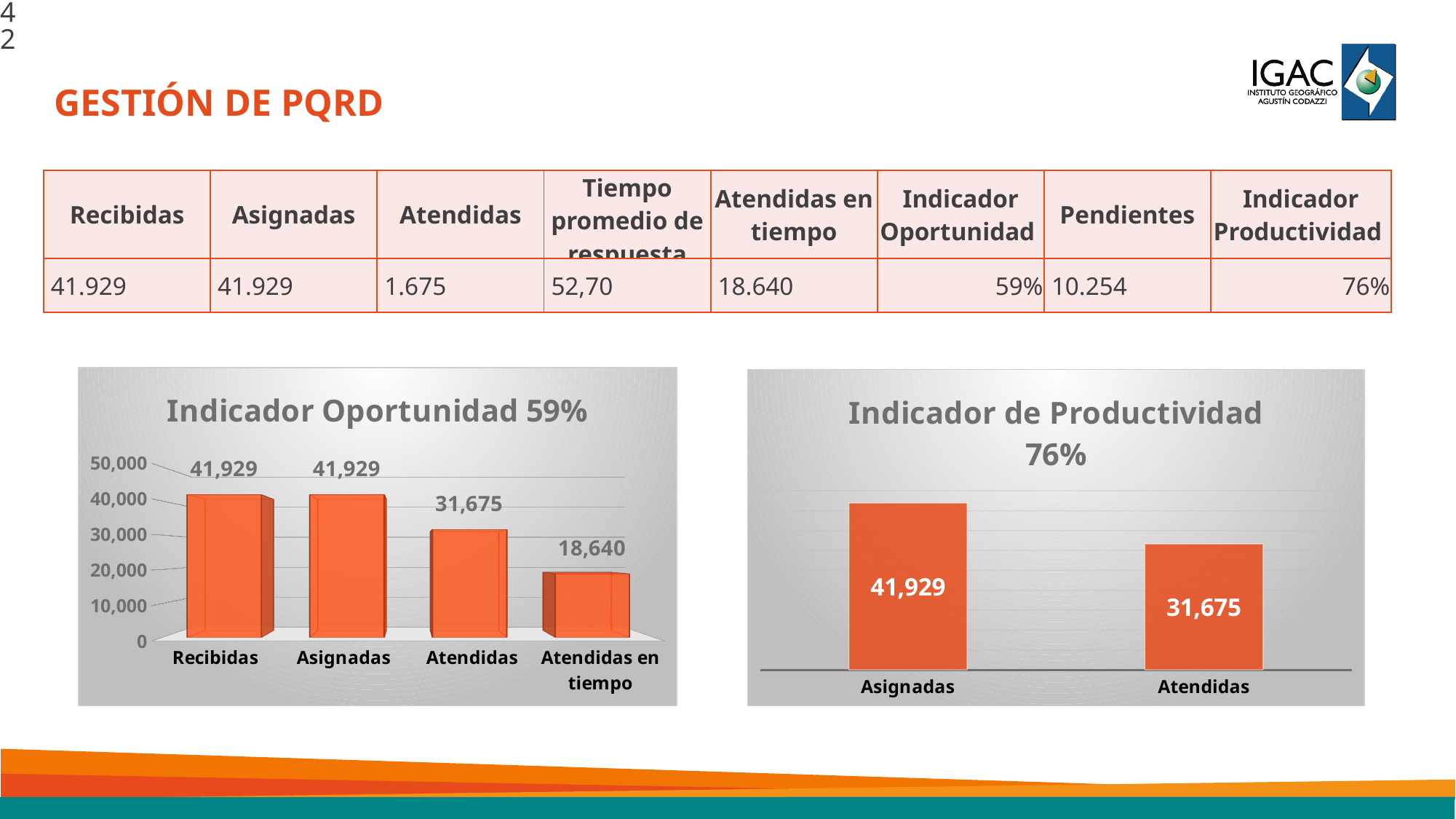
In the 'Indicador Oportunidad 59%' chart, do the values rise or fall from left to right? fall In the 'Indicador Oportunidad 59%' chart, what is the difference between Atendidas and Atendidas en tiempo? 13,035 In the 'Indicador Oportunidad 59%' chart, how many categories are shown on the x axis? 4 In the 'Indicador de Productividad 76%' chart, what is the difference between Asignadas and Atendidas? 10,254 In the 'Indicador Oportunidad 59%' chart, what is the value for Atendidas? 31,675 In the 'Indicador de Productividad 76%' chart, what is the value for Atendidas? 31,675 In the 'Indicador Oportunidad 59%' chart, is the value for Atendidas greater or less than 30,000? greater In the 'Indicador Oportunidad 59%' chart, what is the value for Atendidas en tiempo? 18,640 What kind of chart is the 'Indicador de Productividad 76%' chart? bar chart In the 'Indicador Oportunidad 59%' chart, which category has the lowest value? Atendidas en tiempo In the 'Indicador Oportunidad 59%' chart, what is the value for Recibidas? 41,929 In the 'Indicador de Productividad 76%' chart, which is larger, Asignadas or Atendidas? Asignadas